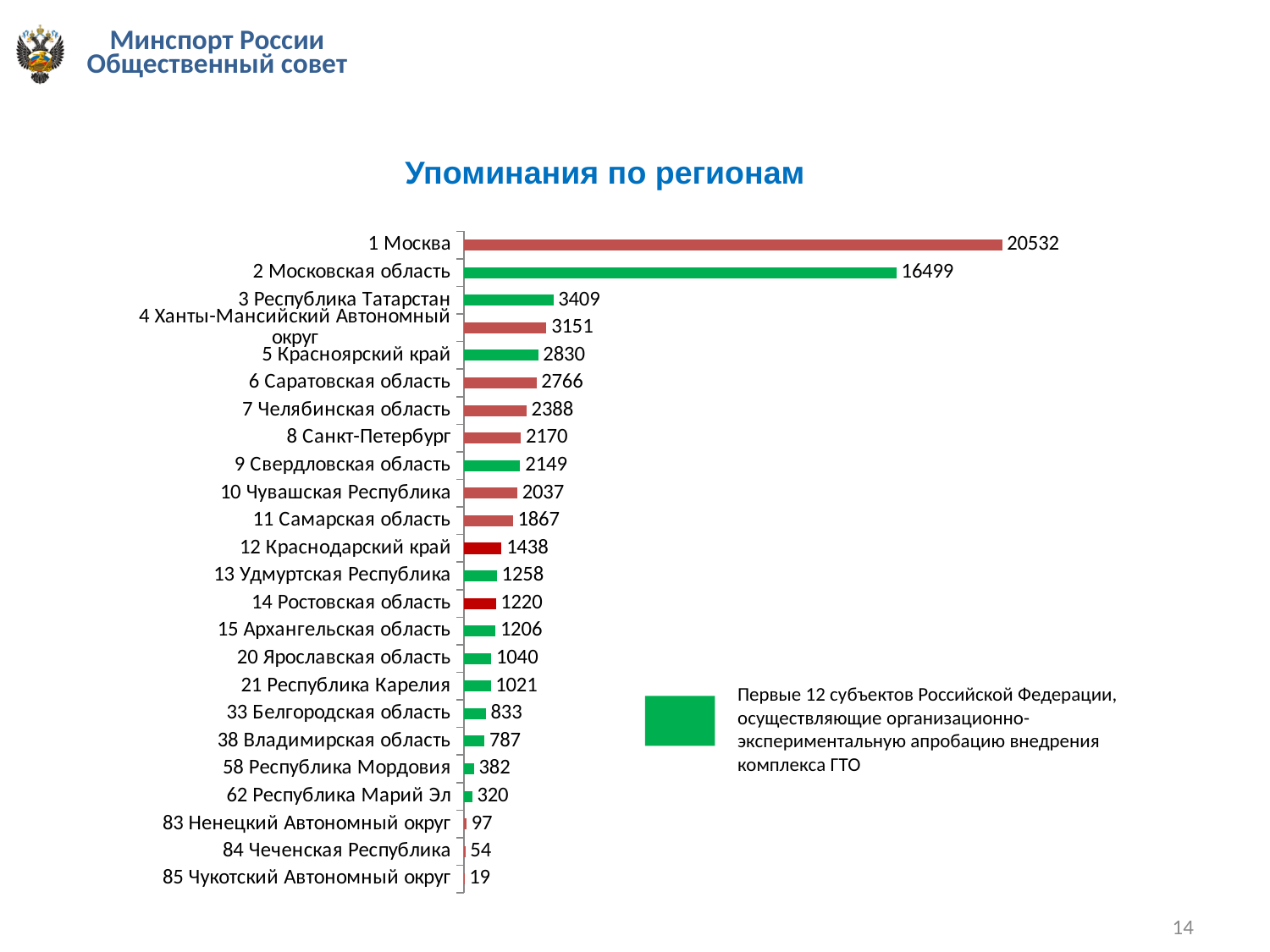
What is the value for 8 Санкт-Петербург? 2170 What is the title of the chart? Упоминания по регионам Which region has the lowest value? 85 Чукотский Автономный округ What is the value for 2 Московская область? 16499 What is the value for 85 Чукотский Автономный округ? 19 Which region has the highest value? 1 Москва How many regions are shown in the chart? 24 What is the difference between the values for 1 Москва and 2 Московская область? 4033 Which is larger, the value for 6 Саратовская область or 7 Челябинская область? 6 Саратовская область What kind of chart is shown on the slide? Bar chart What is the difference between the values for 3 Республика Татарстан and 5 Красноярский край? 579 What is the value for 1 Москва? 20532